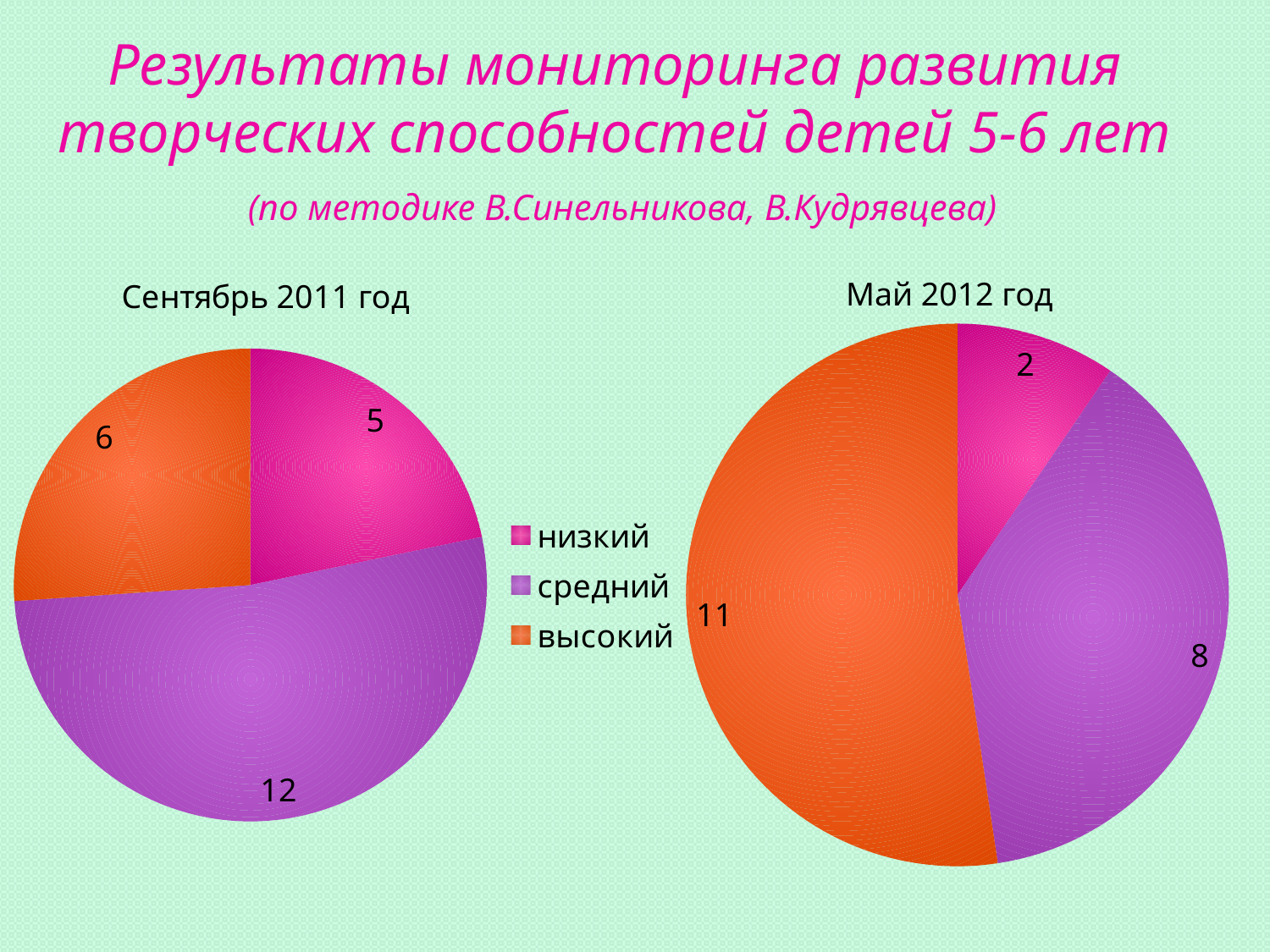
In the "Май 2012 год" chart, what is the value for "высокий"? 11 In the "Май 2012 год" chart, what is the value for "низкий"? 2 What type of chart is used on this slide? Pie chart In the "Май 2012 год" chart, which category has the smallest slice? низкий In the "Сентябрь 2011 год" chart, what is the difference between the values for "средний" and "высокий"? 6 In the "Май 2012 год" chart, what is the difference between the values for "высокий" and "низкий"? 9 In the "Май 2012 год" chart, which category has the largest slice? высокий In the "Сентябрь 2011 год" chart, what is the value for "средний"? 12 Which is larger: the value for "высокий" in the "Сентябрь 2011 год" chart or in the "Май 2012 год" chart? Май 2012 год In the "Сентябрь 2011 год" chart, which category has the largest slice? средний In the "Сентябрь 2011 год" chart, what is the value for "низкий"? 5 How many categories does the legend list? 3